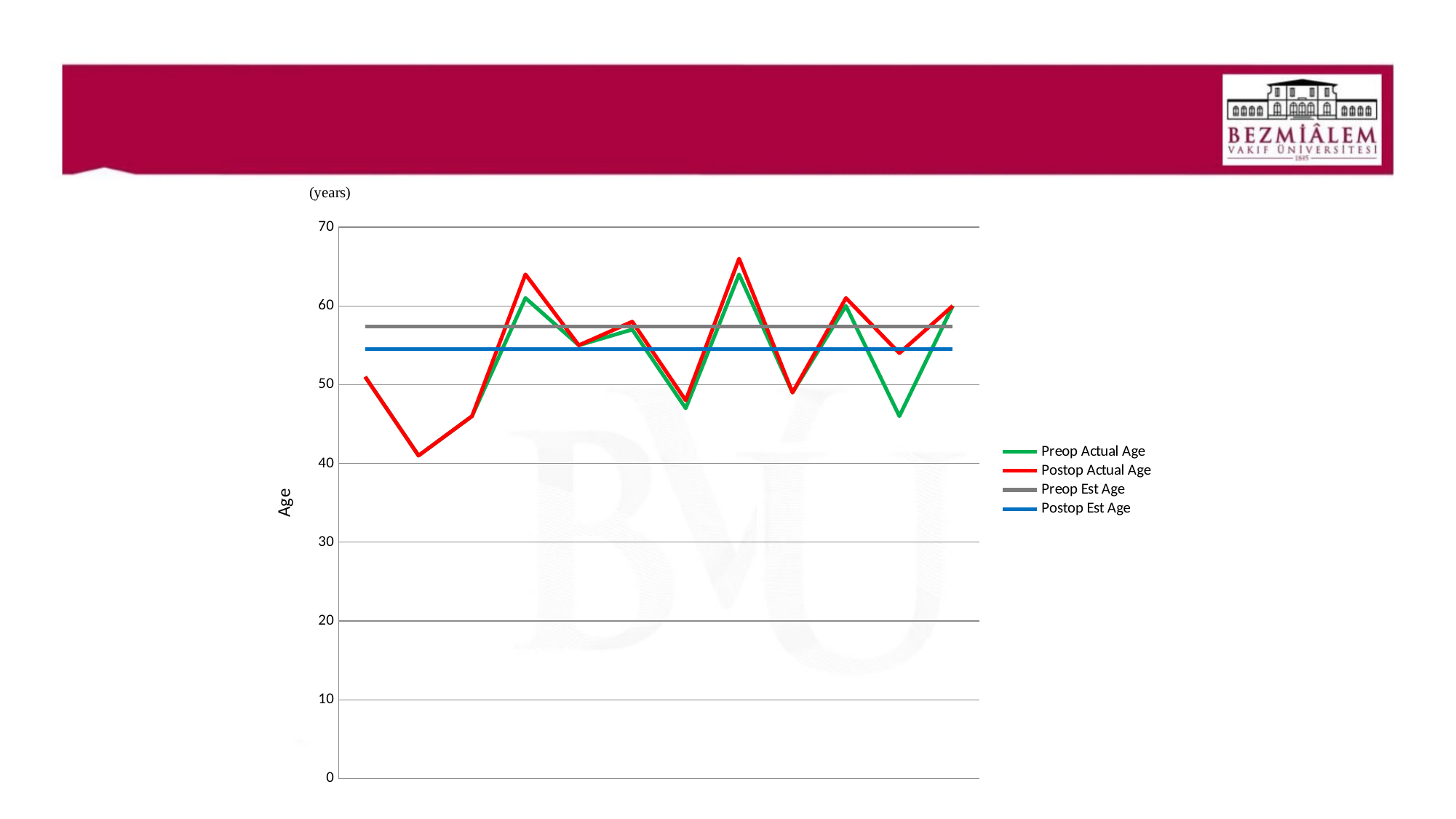
What colour is the Postop Actual Age line? red Is the Preop Est Age line greater or less than 50? greater What kind of chart is shown on the slide? line chart Which series is plotted higher, Preop Est Age or Postop Est Age? Preop Est Age How many series does the legend list? 4 Is the highest point of the Postop Actual Age line greater or less than 60? greater Is the Postop Est Age line greater or less than 60? less What is the label on the y axis? Age How many data points are plotted along the x axis for the Postop Actual Age line? 12